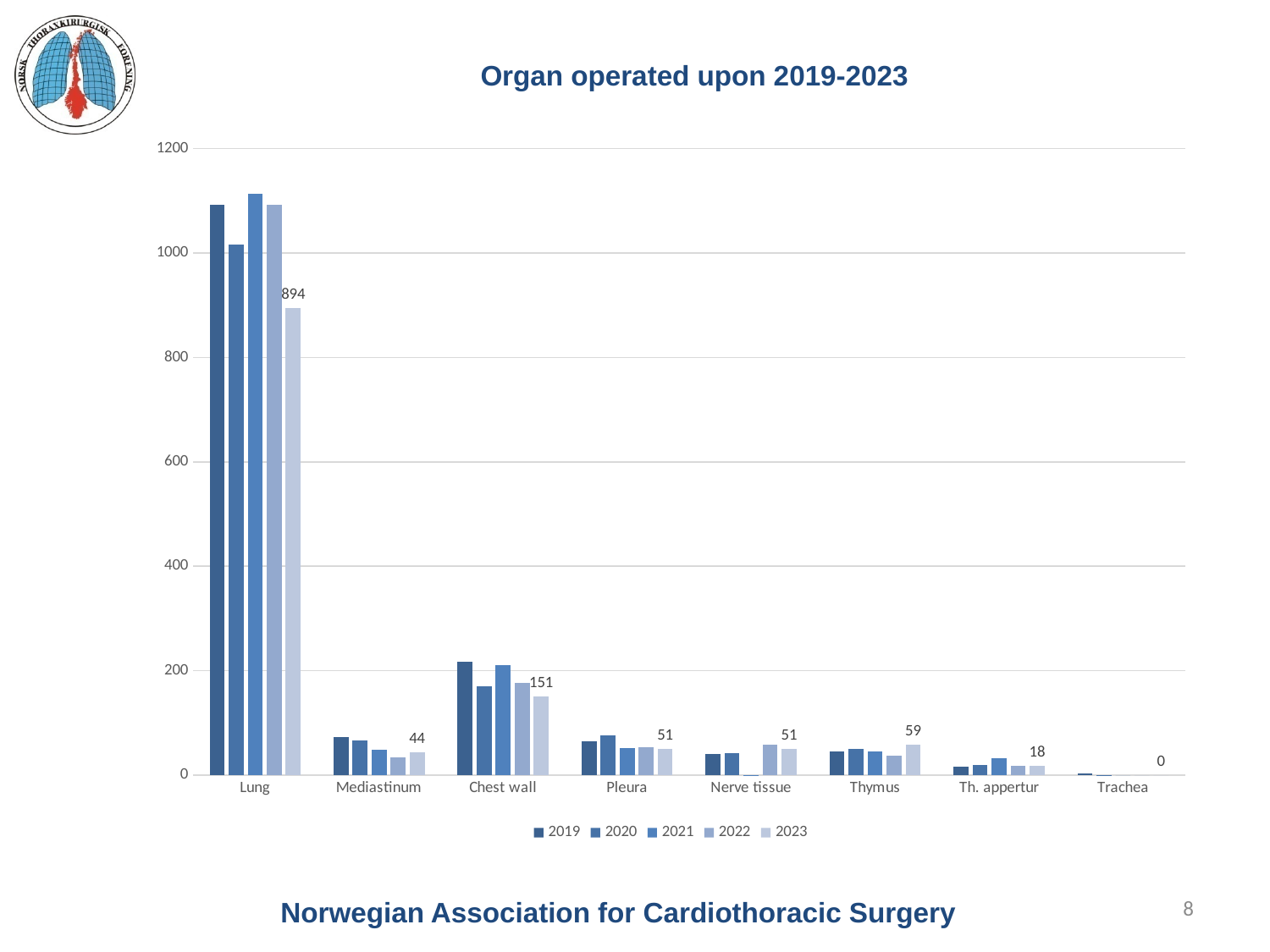
How many organ categories are shown on the x axis? 8 What is the value for Lung in 2023? 894 Which is larger in 2023, Mediastinum or Thymus? Thymus What is the value for Thymus in 2023? 59 Which organ has the lowest number of operations in 2023? Trachea Which organ has the highest number of operations in 2023? Lung What is the value for Chest wall in 2023? 151 Is the value for Lung in 2019 greater or less than 1000? greater What kind of chart is shown on the slide? Bar chart What is the difference between the 2023 values for Lung and Chest wall? 743 What is the value for Trachea in 2023? 0 How many series does the legend list? 5